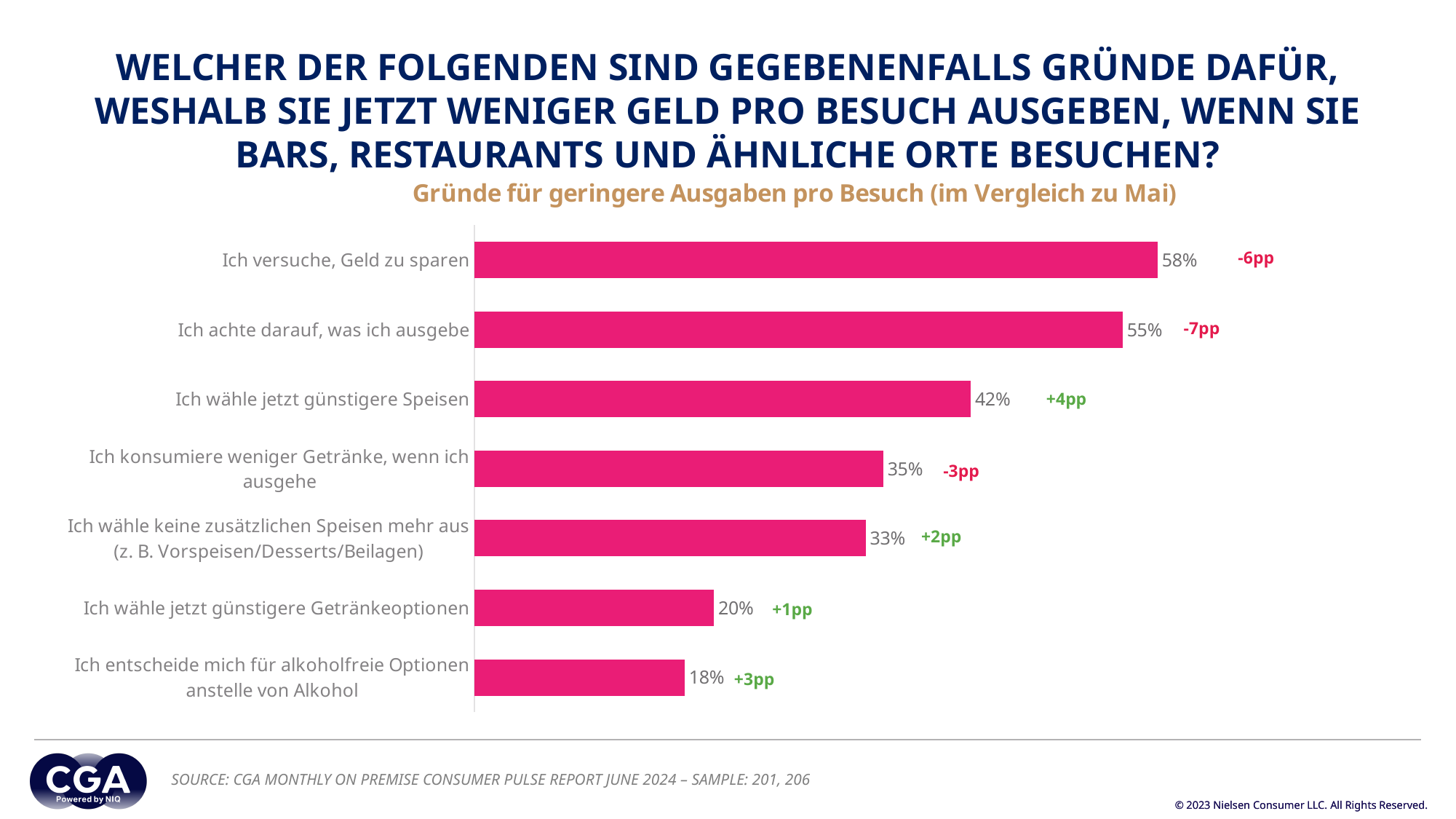
What is the change versus May shown next to "Ich achte darauf, was ich ausgebe"? -7pp What is the difference in percentage points between "Ich versuche, Geld zu sparen" and "Ich achte darauf, was ich ausgebe"? 3 percentage points What percentage is shown for "Ich entscheide mich für alkoholfreie Optionen anstelle von Alkohol"? 18% Which is larger: the value for "Ich konsumiere weniger Getränke, wenn ich ausgehe" or for "Ich wähle keine zusätzlichen Speisen mehr aus"? Ich konsumiere weniger Getränke, wenn ich ausgehe What percentage is shown for "Ich wähle jetzt günstigere Speisen"? 42% What is the subtitle of the chart shown in orange text? Gründe für geringere Ausgaben pro Besuch (im Vergleich zu Mai) Which reason has the lowest percentage? Ich entscheide mich für alkoholfreie Optionen anstelle von Alkohol What is the change versus May shown next to "Ich wähle jetzt günstigere Getränkeoptionen"? +1pp What percentage is shown for "Ich versuche, Geld zu sparen"? 58% What type of chart is shown on the slide? Bar chart How many reasons (bars) are shown in the chart? 7 Which reason has the highest percentage? Ich versuche, Geld zu sparen